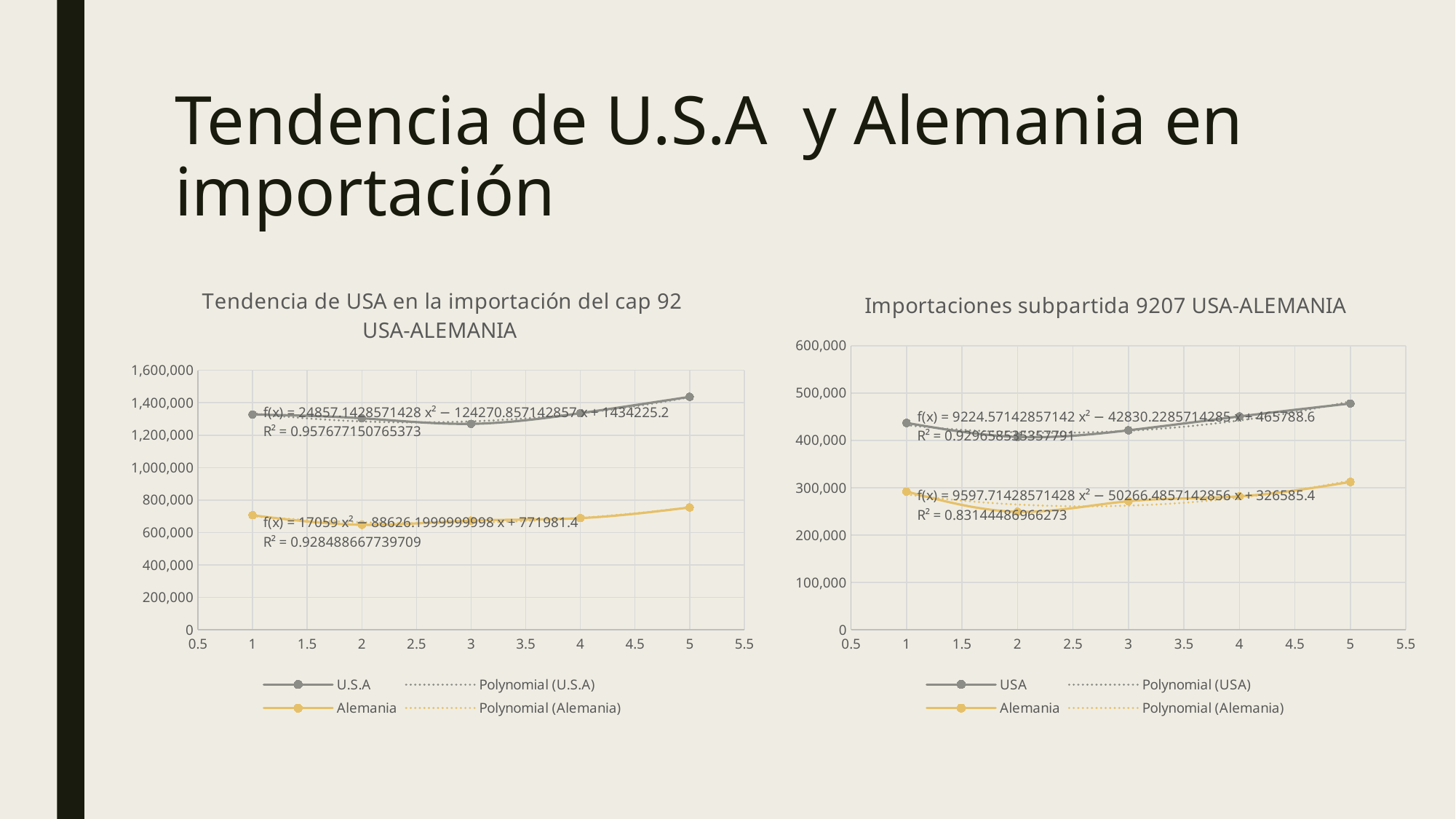
In the right chart, at which x value does the USA series reach its lowest point? 2 What kind of chart is the chart titled 'Importaciones subpartida 9207 USA-ALEMANIA'? line chart In the right chart, at which x value does the Alemania series reach its highest point? 5 In the chart titled 'Importaciones subpartida 9207 USA-ALEMANIA', is the Alemania value at x = 5 greater or less than 300,000? greater In the chart titled 'Tendencia de USA en la importación del cap 92 USA-ALEMANIA', is the U.S.A value at x = 5 greater or less than 1,400,000? greater In the right chart, which series has the larger value at x = 1, USA or Alemania? USA In the left chart, how many entries does the legend list? 4 In the left chart, at which x value does the U.S.A series reach its lowest point? 3 In the left chart, at which x value does the U.S.A series reach its highest point? 5 In the right chart, what R² value is shown for the USA polynomial trendline? 0.929658535357791 In the chart titled 'Tendencia de USA en la importación del cap 92 USA-ALEMANIA', is the Alemania value at x = 2 greater or less than 800,000? less In the left chart, how many data points does the Alemania series have? 5